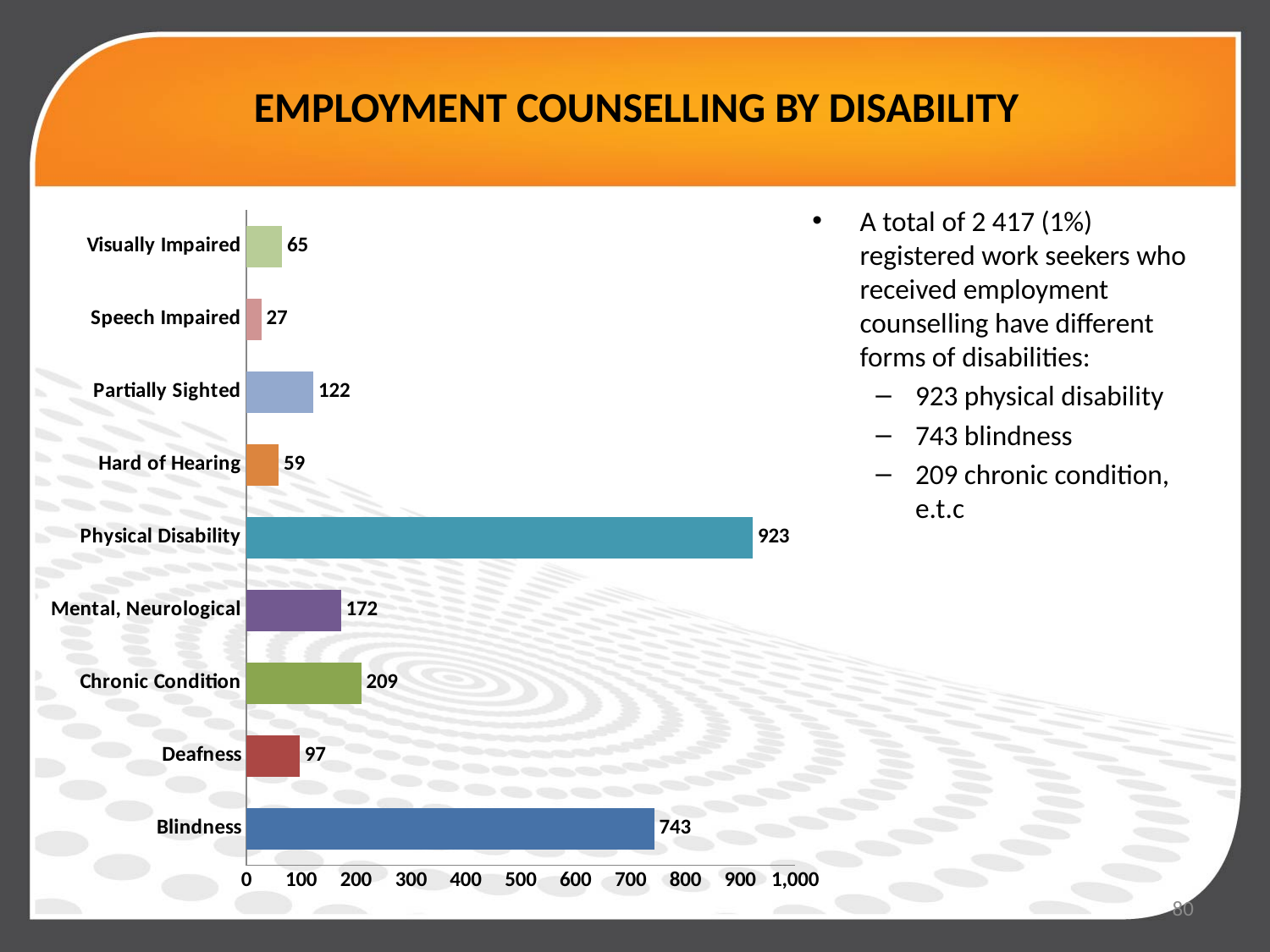
What is the value for Mental, Neurological? 172 What is the value for Speech Impaired? 27 Which category has the lowest value? Speech Impaired What is the value for Blindness? 743 What is the value for Physical Disability? 923 How many categories are shown in the chart? 9 Which category has the highest value? Physical Disability What kind of chart is shown on the slide? bar chart What is the difference between the values for Chronic Condition and Mental, Neurological? 37 What is the difference between the values for Physical Disability and Blindness? 180 Which is larger, the value for Partially Sighted or the value for Deafness? Partially Sighted Is the value for Hard of Hearing greater or less than 100? less